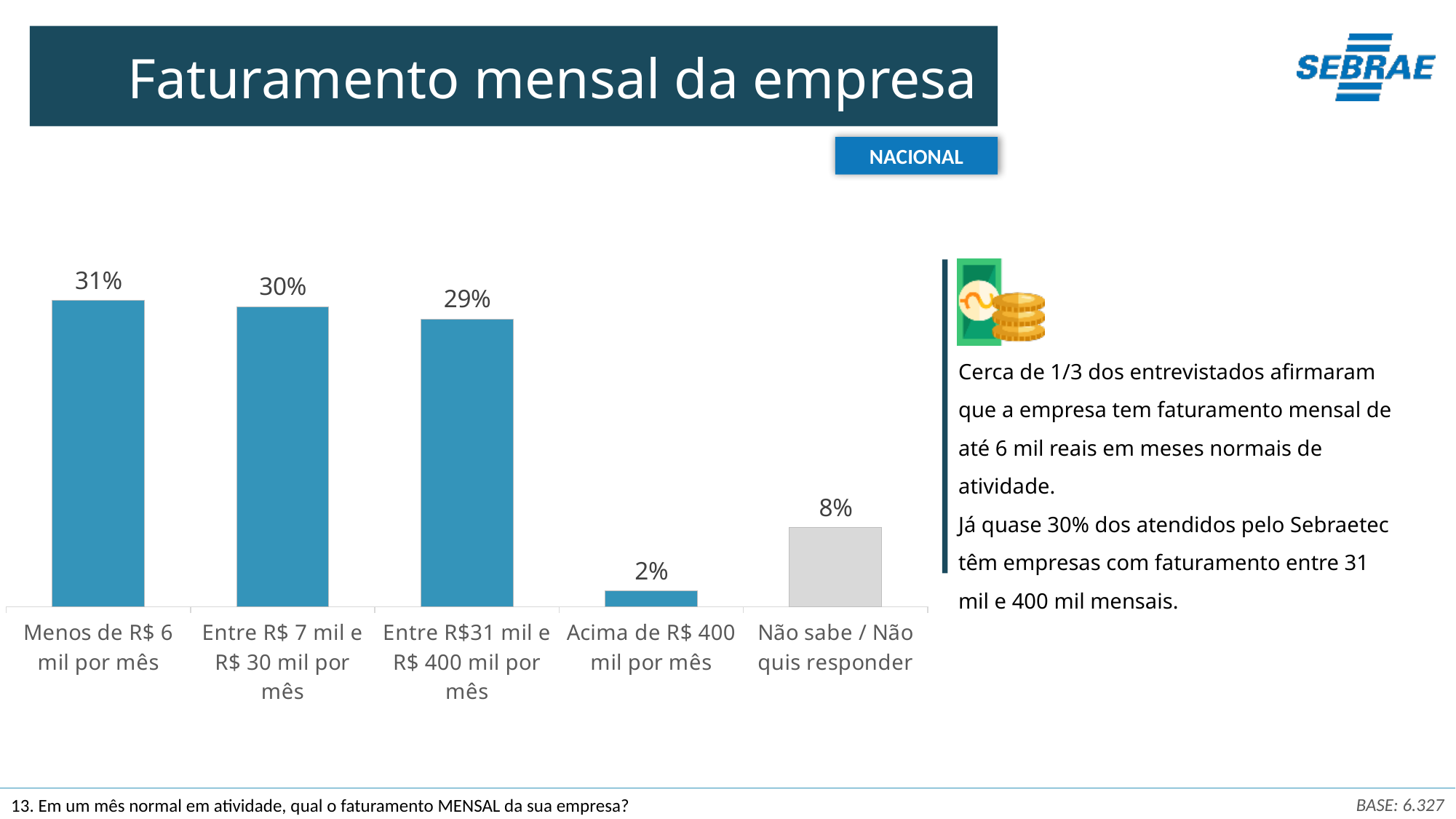
Which bar in the chart is coloured grey rather than blue? Não sabe / Não quis responder What is the difference between the values for 'Menos de R$ 6 mil por mês' and 'Acima de R$ 400 mil por mês'? 29 percentage points What percentage of respondents reported revenue 'Acima de R$ 400 mil por mês'? 2% How many categories are shown in the chart? 5 What is the value for 'Não sabe / Não quis responder'? 8% What is the value shown for 'Entre R$31 mil e R$ 400 mil por mês'? 29% What type of chart is shown on the slide? Bar chart Which category has the highest value in the chart? Menos de R$ 6 mil por mês Which category has the lowest value in the chart? Acima de R$ 400 mil por mês Which is larger: the value for 'Não sabe / Não quis responder' or the value for 'Acima de R$ 400 mil por mês'? Não sabe / Não quis responder What is the value shown for 'Entre R$ 7 mil e R$ 30 mil por mês'? 30% What percentage of respondents reported monthly revenue of 'Menos de R$ 6 mil por mês'? 31%